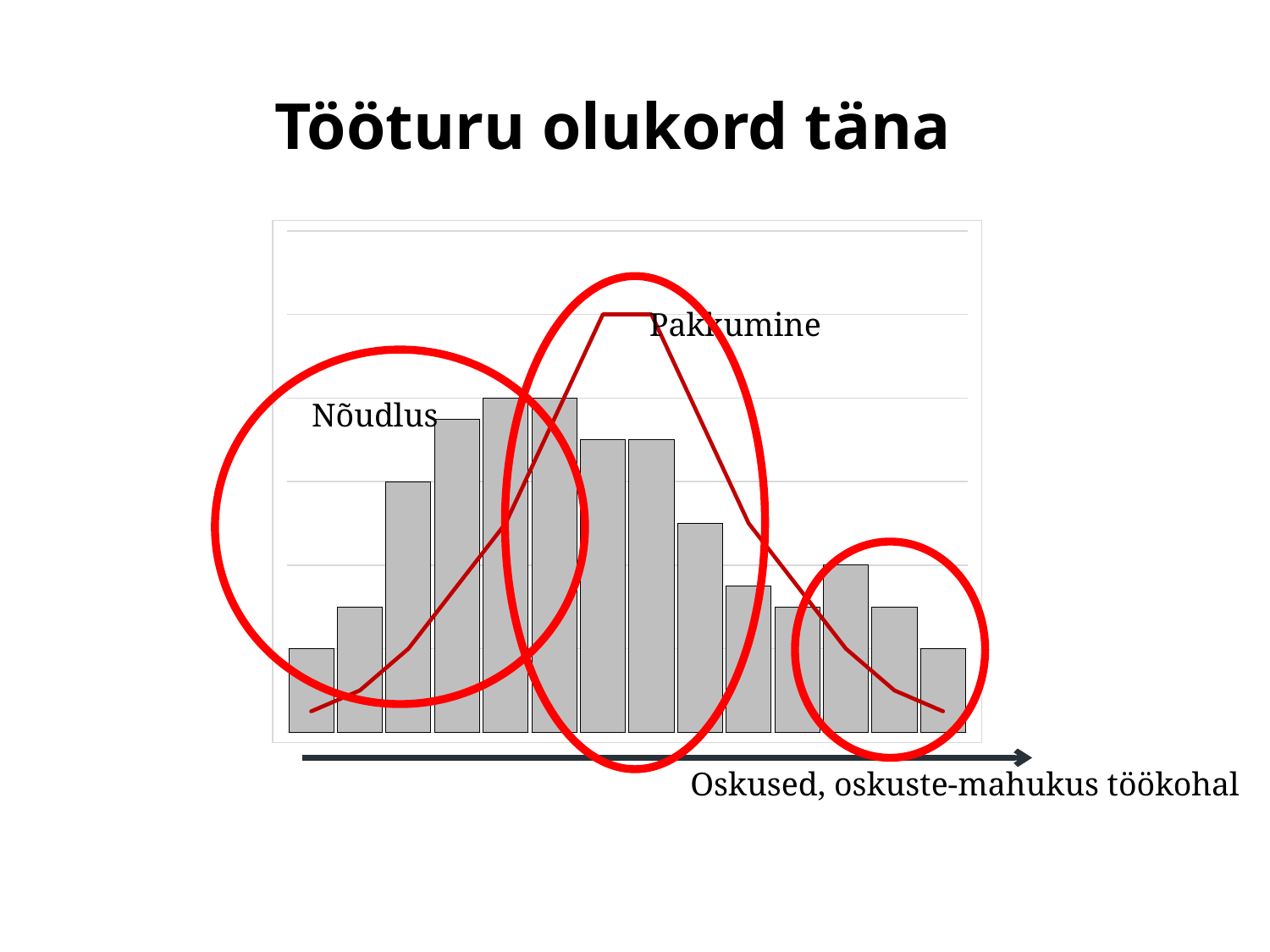
How many bars are plotted in the chart? 14 Do the bars rise or fall from the first bar to the fifth bar? Rise What kind of chart is shown on the slide? A bar chart with a line overlay Does the Pakkumine line rise or fall after reaching its peak? Fall Which is taller, the second bar or the third bar from the left? The third bar Which reaches higher on the chart, the peak of the Pakkumine line or the tallest Nõudlus bar? The peak of the Pakkumine line What is the label on the horizontal axis? Oskused, oskuste-mahukus töökohal What label is given to the line in the chart? Pakkumine How many red circles are drawn over the chart? 3 What label is given to the bars in the chart? Nõudlus Do the bars rise or fall from the seventh bar to the eleventh bar? Fall